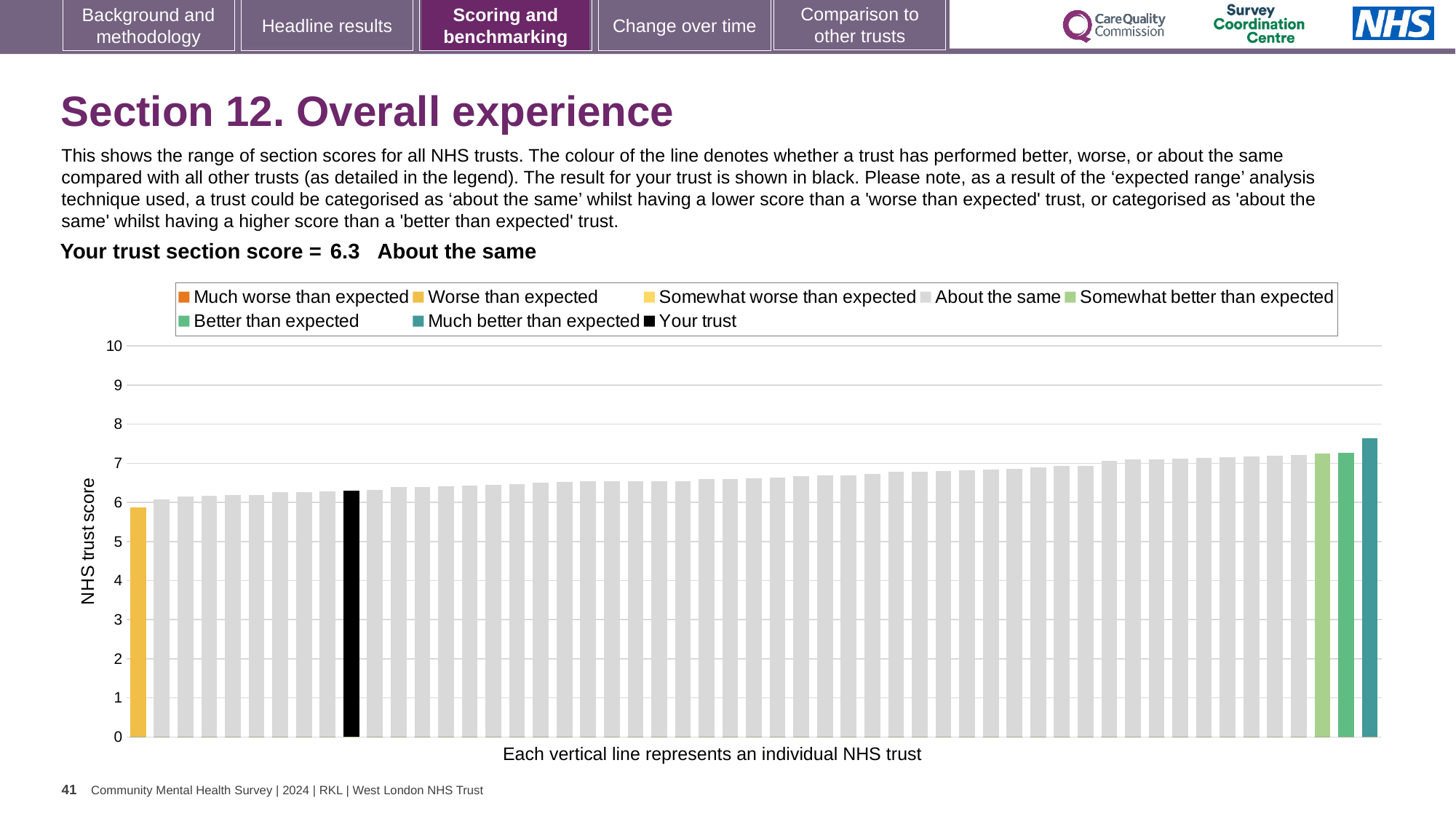
Is the black 'Your trust' bar higher or lower than the yellow 'Worse than expected' bar? higher Which category is your trust placed in for this section? About the same Is the shortest bar in the chart greater or less than 7? less How many entries does the chart legend list? 8 Which legend category does the shortest bar belong to? Worse than expected What is the label on the vertical axis of the chart? NHS trust score What is the section score for your trust shown on the slide? 6.3 Do the bar values rise or fall from left to right along the x axis? rise What kind of chart is shown on the slide? bar chart Is the tallest bar in the chart greater or less than 7? greater Is the value for your trust (the black bar) greater or less than 5? greater Which legend category does the tallest bar belong to? Much better than expected